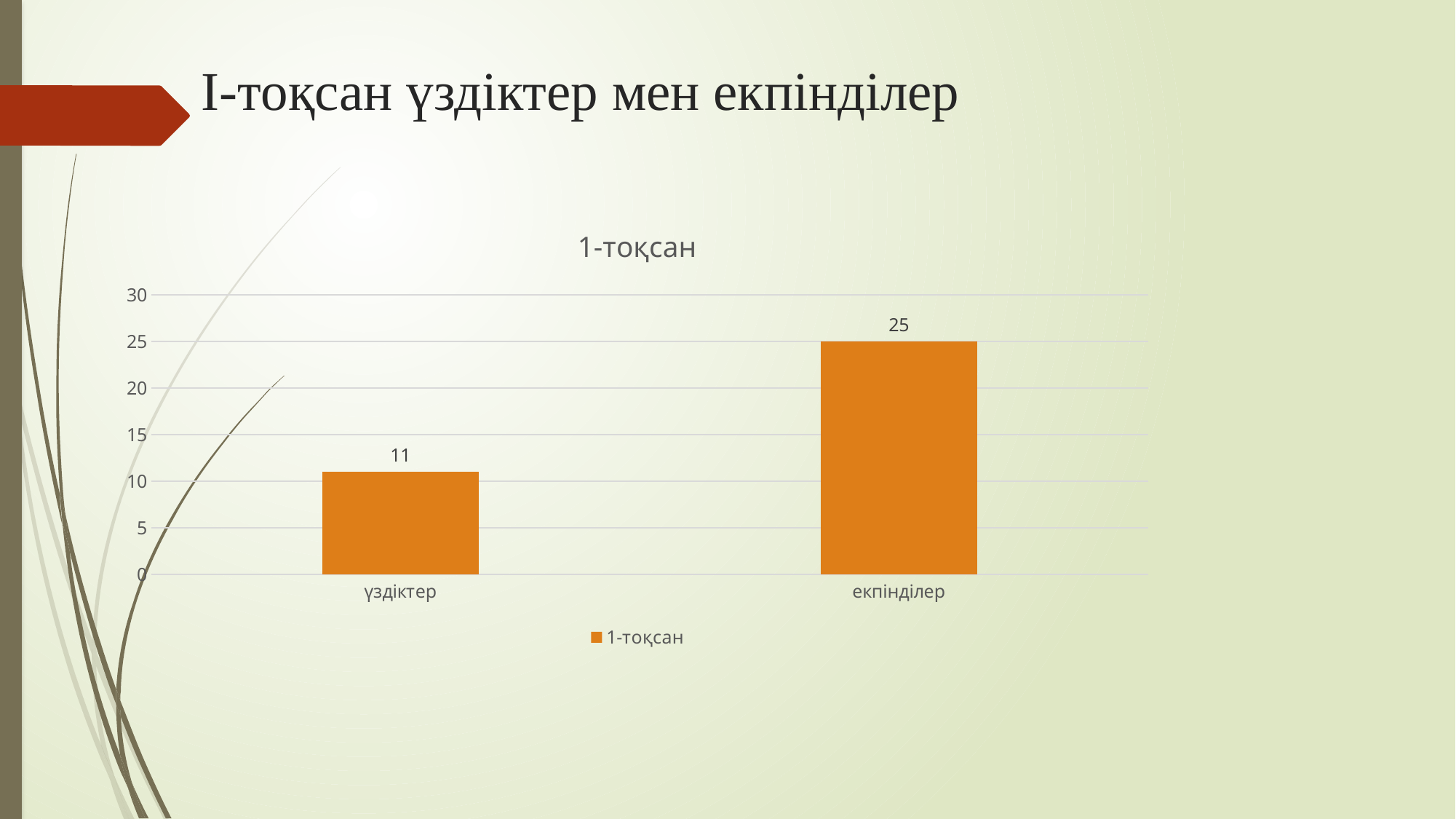
Which category has the lowest value? үздіктер What kind of chart is shown on the slide? bar chart What is the value for екпінділер? 25 What is the title of the chart? 1-тоқсан What is the value for үздіктер? 11 Which is larger, the value for үздіктер or the value for екпінділер? екпінділер How many categories are shown on the x axis? 2 How many series does the legend list? 1 Is the value for екпінділер greater or less than 20? greater Which category has the highest value? екпінділер What is the difference between the values for екпінділер and үздіктер? 14 Is the value for үздіктер greater or less than 15? less